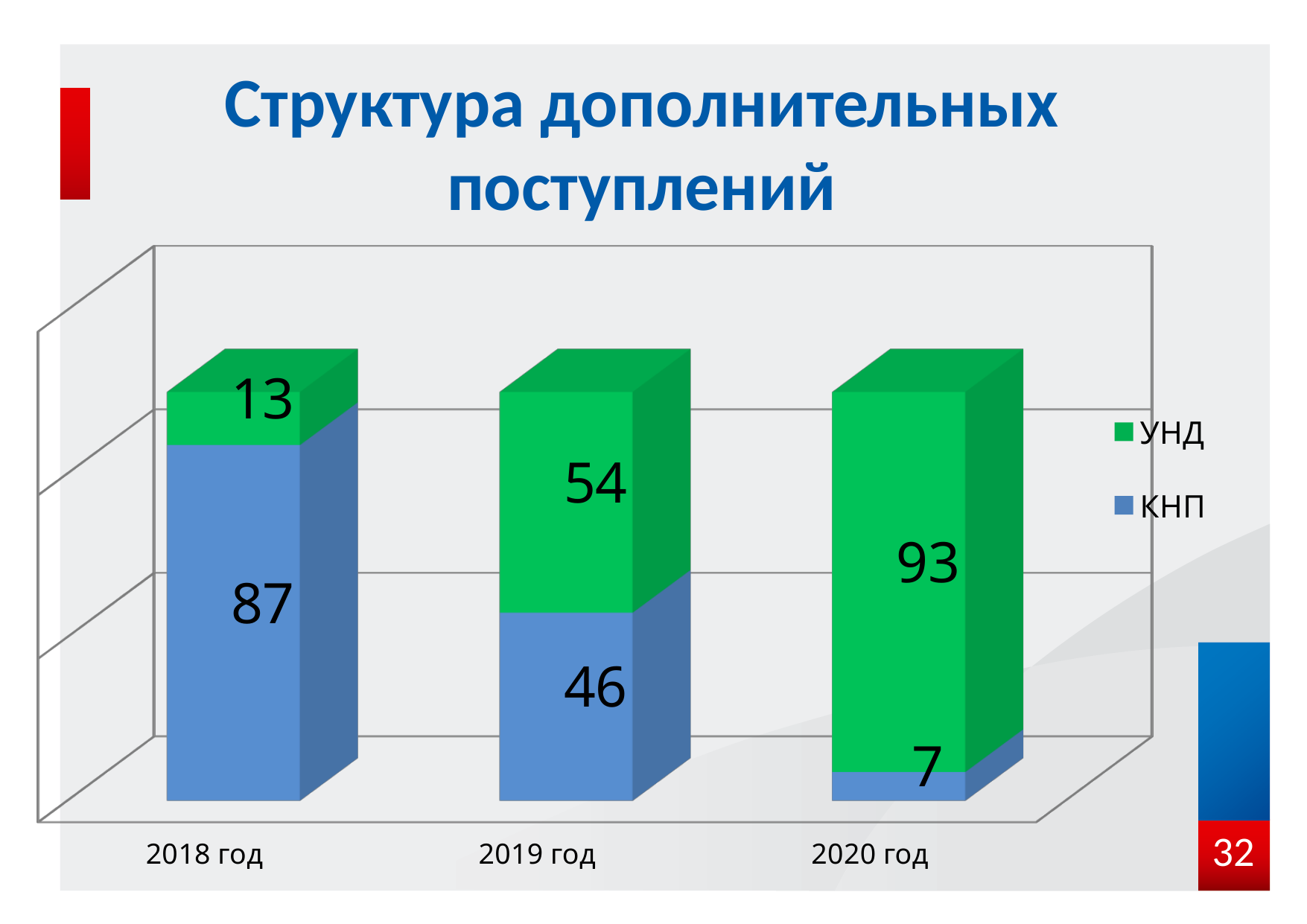
Which is larger for 2019 год, УНД or КНП? УНД How many series does the legend list? 2 What is the value of КНП for 2020 год? 7 What is the total of the stacked bar for 2018 год? 100 What is the difference between the КНП values for 2018 год and 2019 год? 41 In which year is the КНП value lowest? 2020 год What kind of chart is shown on the slide? Stacked bar chart What is the value of УНД for 2019 год? 54 In which year is the УНД value highest? 2020 год What is the value of УНД for 2020 год? 93 What is the value of КНП for 2018 год? 87 How many years are shown on the x axis? 3